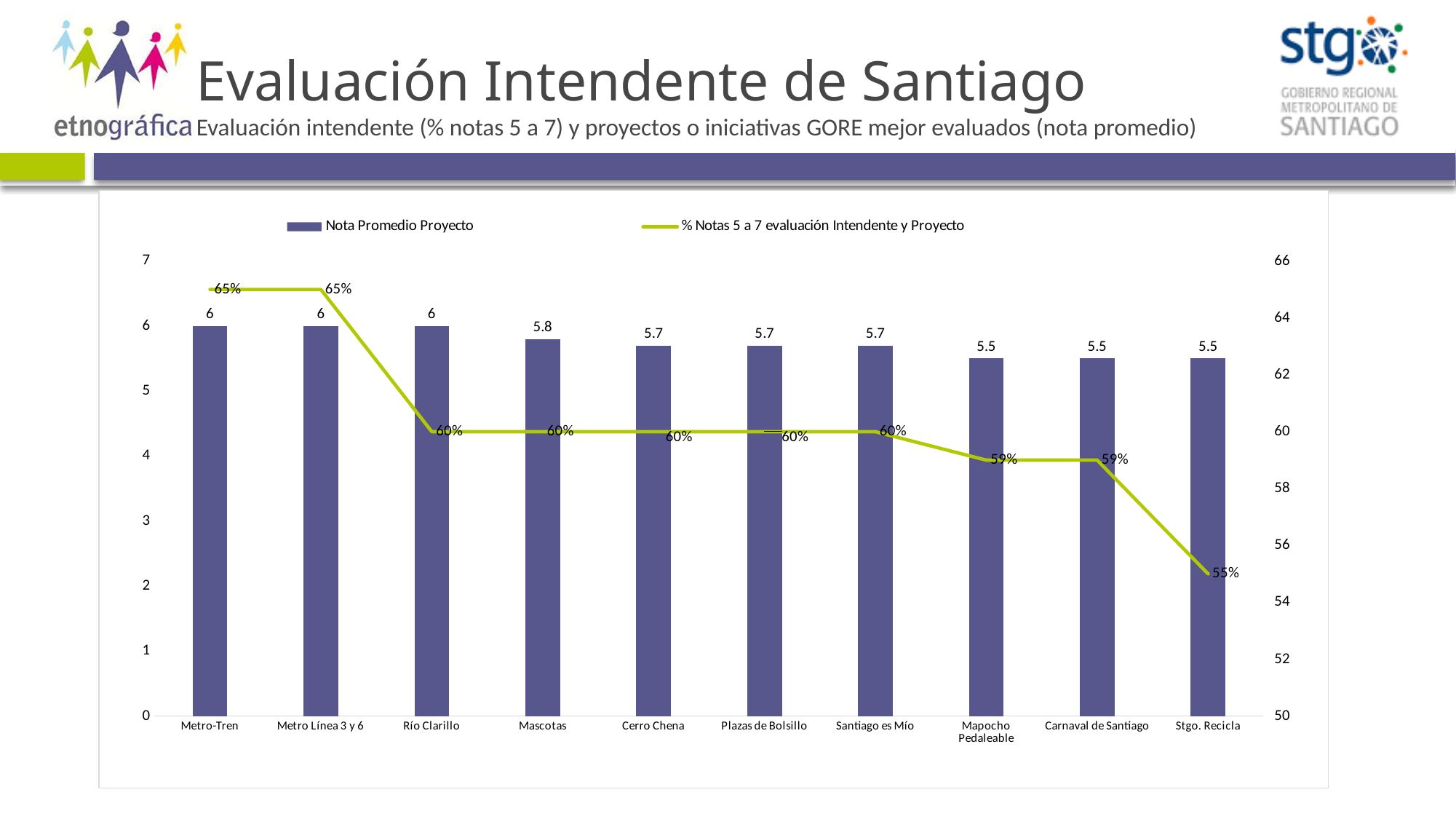
What is the difference between the Nota Promedio Proyecto values for Río Clarillo and Carnaval de Santiago? 0.5 What is the difference between the % Notas 5 a 7 values for Metro Línea 3 y 6 and Mapocho Pedaleable? 6% How many series does the legend list? 2 What is the % Notas 5 a 7 evaluación Intendente y Proyecto value for Metro-Tren? 65% What is the Nota Promedio Proyecto value for Mascotas? 5.8 What colour is the line for % Notas 5 a 7 evaluación Intendente y Proyecto? green What is the % Notas 5 a 7 evaluación Intendente y Proyecto value for Stgo. Recicla? 55% Which category has the lowest % Notas 5 a 7 evaluación Intendente y Proyecto value? Stgo. Recicla What is the Nota Promedio Proyecto value for Cerro Chena? 5.7 Which has a higher Nota Promedio Proyecto value, Mascotas or Stgo. Recicla? Mascotas Do the Nota Promedio Proyecto values rise or fall from left to right along the x axis? fall How many categories are shown on the x axis of the chart? 10